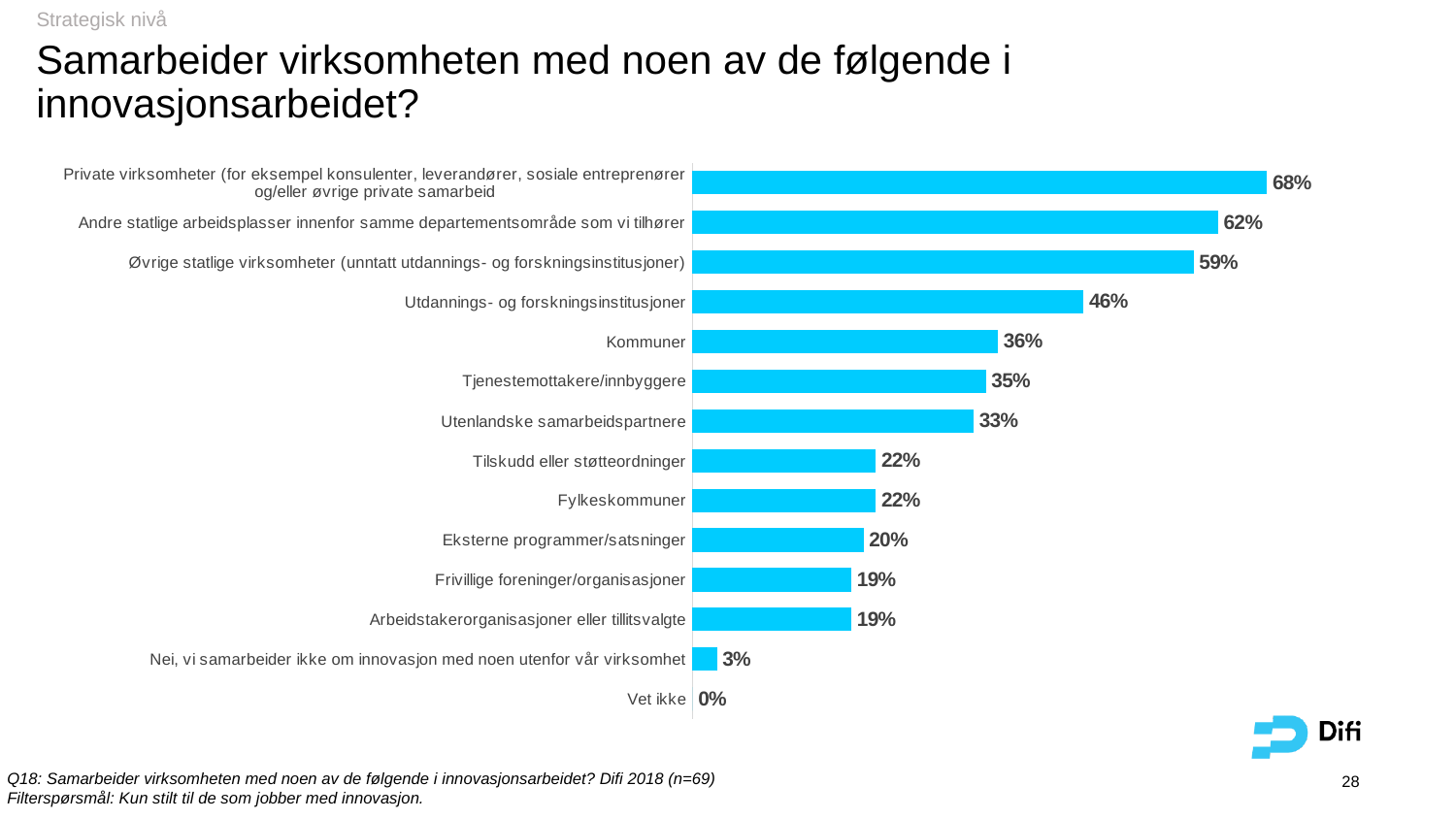
Which category has the lowest value? Vet ikke What is the value for Vet ikke? 0% What is the value for Utenlandske samarbeidspartnere? 33% What is the value for Nei, vi samarbeider ikke om innovasjon med noen utenfor vår virksomhet? 3% How many categories are shown in the chart? 14 Which category has the highest value? Private virksomheter (for eksempel konsulenter, leverandører, sosiale entreprenører og/eller øvrige private samarbeid What kind of chart is shown on the slide? Bar chart What is the value for Kommuner? 36% What is the difference between the values for Utdannings- og forskningsinstitusjoner and Kommuner? 10% Which is larger: the value for Tjenestemottakere/innbyggere or the value for Eksterne programmer/satsninger? Tjenestemottakere/innbyggere What is the value for Utdannings- og forskningsinstitusjoner? 46% What is the difference between the values for Andre statlige arbeidsplasser innenfor samme departementsområde som vi tilhører and Øvrige statlige virksomheter (unntatt utdannings- og forskningsinstitusjoner)? 3%